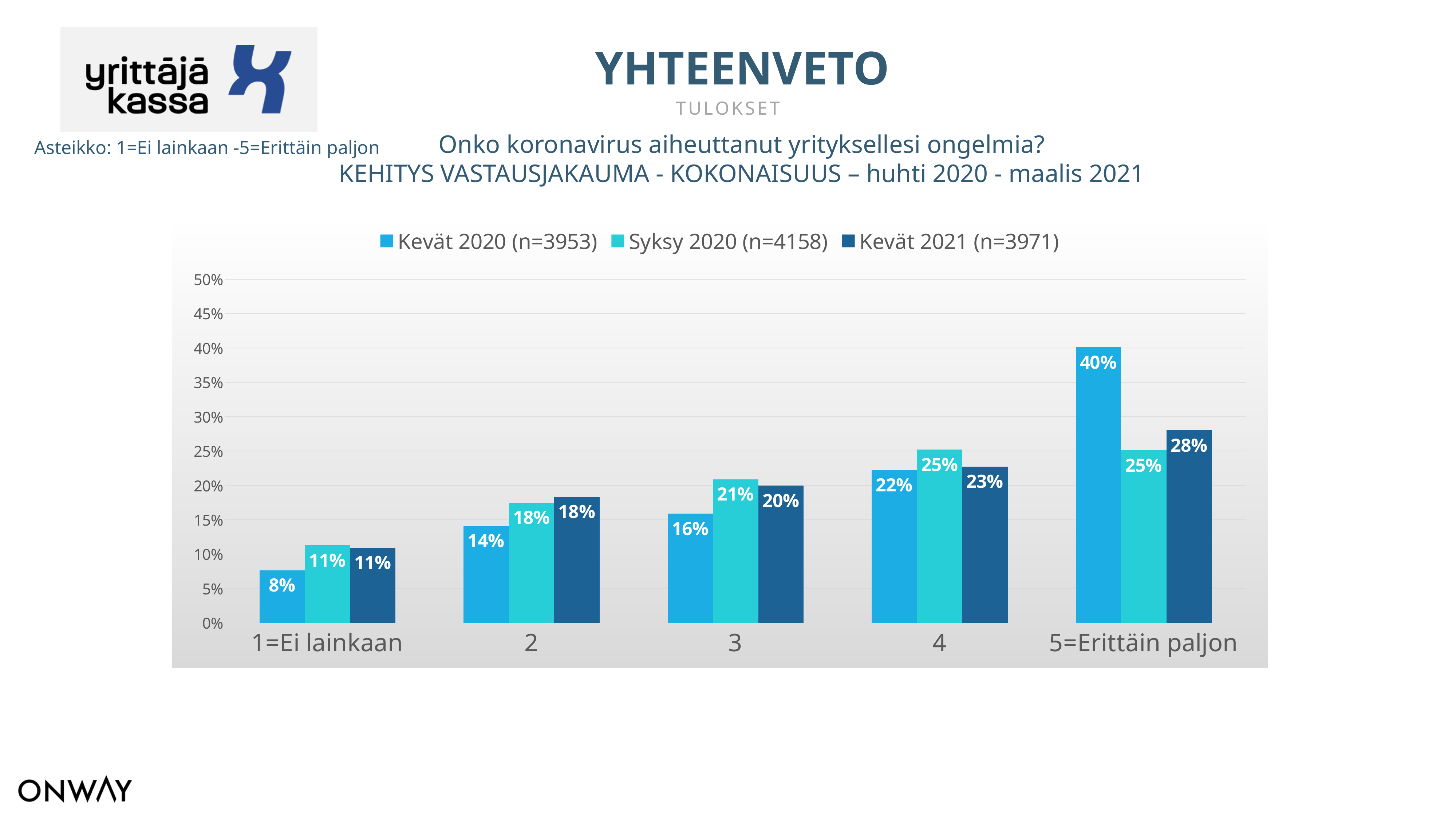
How many categories are shown on the x axis? 5 What is the difference between Kevät 2020 (n=3953) and Kevät 2021 (n=3971) at 5=Erittäin paljon? 12% What is the value for Kevät 2021 (n=3971) at 1=Ei lainkaan? 11% How many series does the legend list? 3 What is the value for Kevät 2020 (n=3953) at 5=Erittäin paljon? 40% Which category has the lowest value for Kevät 2021 (n=3971)? 1=Ei lainkaan Is the value for Kevät 2020 (n=3953) at 5=Erittäin paljon greater or less than 35%? greater Which category has the highest value for Kevät 2020 (n=3953)? 5=Erittäin paljon What kind of chart is shown on the slide? bar chart What is the value for Syksy 2020 (n=4158) at category 3? 21% Do the values for Kevät 2021 (n=3971) rise or fall from 1=Ei lainkaan to 5=Erittäin paljon? rise Which is larger at category 4: Syksy 2020 (n=4158) or Kevät 2020 (n=3953)? Syksy 2020 (n=4158)